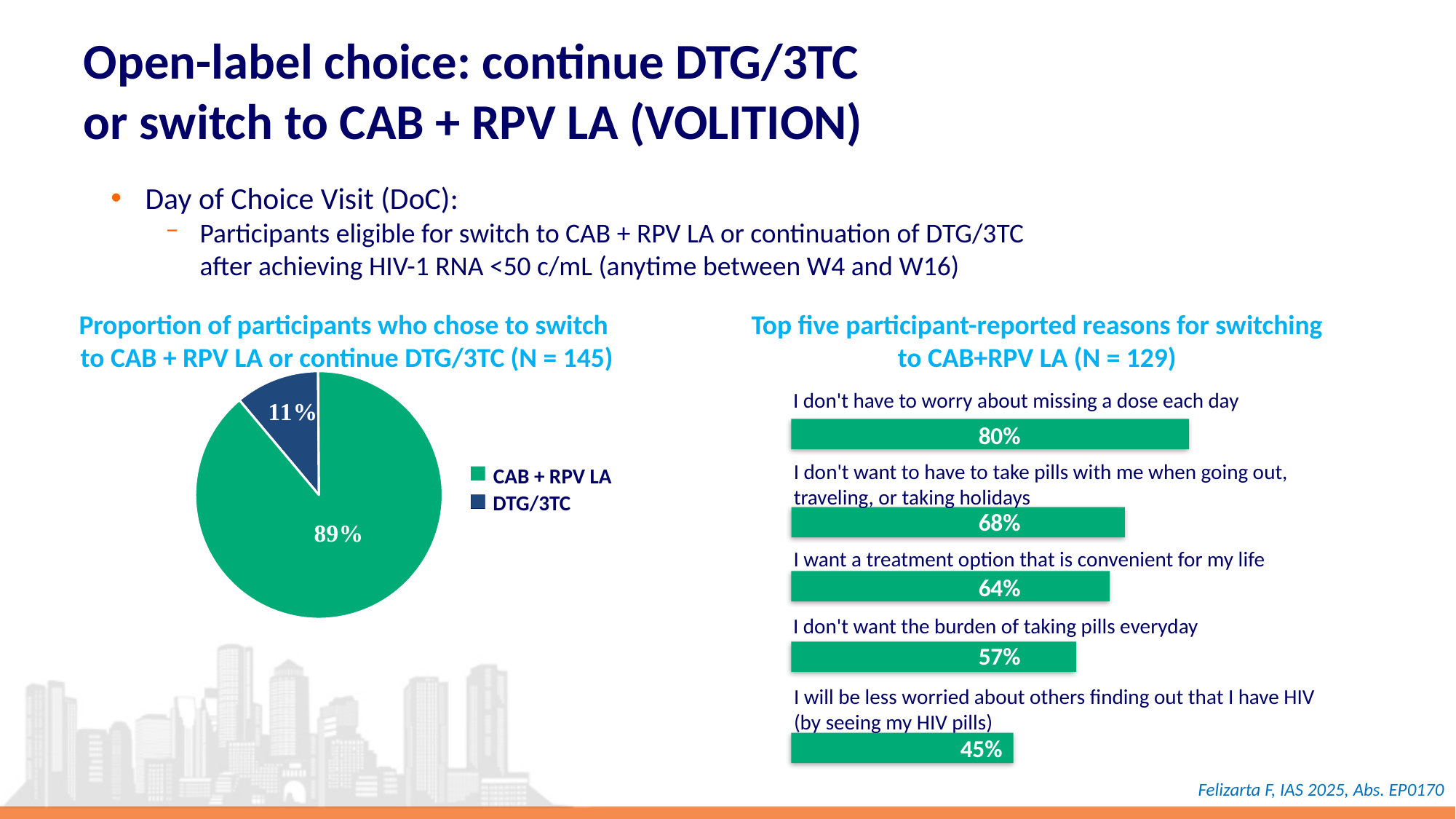
In the bar chart on the right, what is the difference between the percentages for 'I don't have to worry about missing a dose each day' and 'I don't want the burden of taking pills everyday'? 23% In the bar chart on the right, which reason has the lowest percentage? I will be less worried about others finding out that I have HIV (by seeing my HIV pills) In the bar chart on the right, what percentage of participants gave the reason 'I don't have to worry about missing a dose each day'? 80% In the pie chart on the left, what share of participants chose CAB + RPV LA? 89% What kind of chart is the chart on the right of the slide? Bar chart How many reasons are shown in the bar chart on the right? 5 What kind of chart is the chart on the left of the slide? Pie chart In the pie chart on the left, which option did the larger share of participants choose? CAB + RPV LA In the pie chart on the left, what share of participants chose to continue DTG/3TC? 11% In the bar chart on the right, which is larger: the percentage for 'I don't want to have to take pills with me when going out, traveling, or taking holidays' or for 'I want a treatment option that is convenient for my life'? I don't want to have to take pills with me when going out, traveling, or taking holidays In the bar chart on the right, what percentage of participants gave the reason 'I want a treatment option that is convenient for my life'? 64% In the pie chart on the left, how many slices are shown? 2